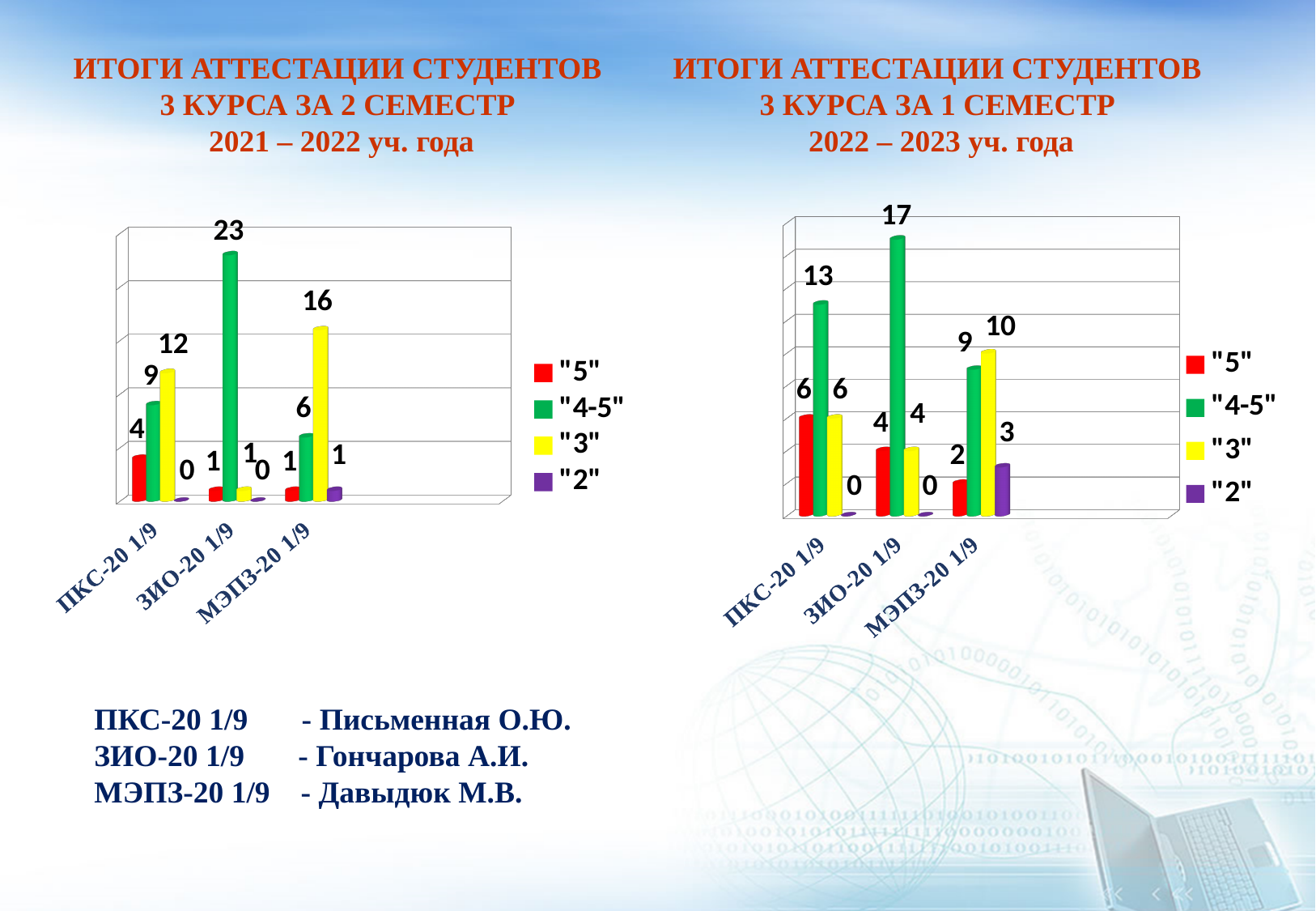
In the left chart (2 семестр 2021 – 2022), what is the value of the "4-5" series for ЗИО-20 1/9? 23 In the left chart (2 семестр 2021 – 2022), what is the value of the "3" series for МЭПЗ-20 1/9? 16 In the left chart (2 семестр 2021 – 2022), which is larger for ПКС-20 1/9: the "3" value or the "4-5" value? "3" In the right chart (1 семестр 2022 – 2023), what is the total of all four series for МЭПЗ-20 1/9? 24 In the right chart (1 семестр 2022 – 2023), what is the difference between the "4-5" values for ЗИО-20 1/9 and ПКС-20 1/9? 4 In the right chart (1 семестр 2022 – 2023), which category has the lowest value for the "4-5" series? МЭПЗ-20 1/9 In the right chart (1 семестр 2022 – 2023), what is the value of the "2" series for МЭПЗ-20 1/9? 3 How many series does the legend of the left chart (2 семестр 2021 – 2022) list? 4 What type of chart is the left chart (2 семестр 2021 – 2022)? Bar chart How many categories are shown on the x axis of the right chart (1 семестр 2022 – 2023)? 3 In the right chart (1 семестр 2022 – 2023), what is the value of the "5" series for ПКС-20 1/9? 6 In the left chart (2 семестр 2021 – 2022), which category has the highest value for the "4-5" series? ЗИО-20 1/9